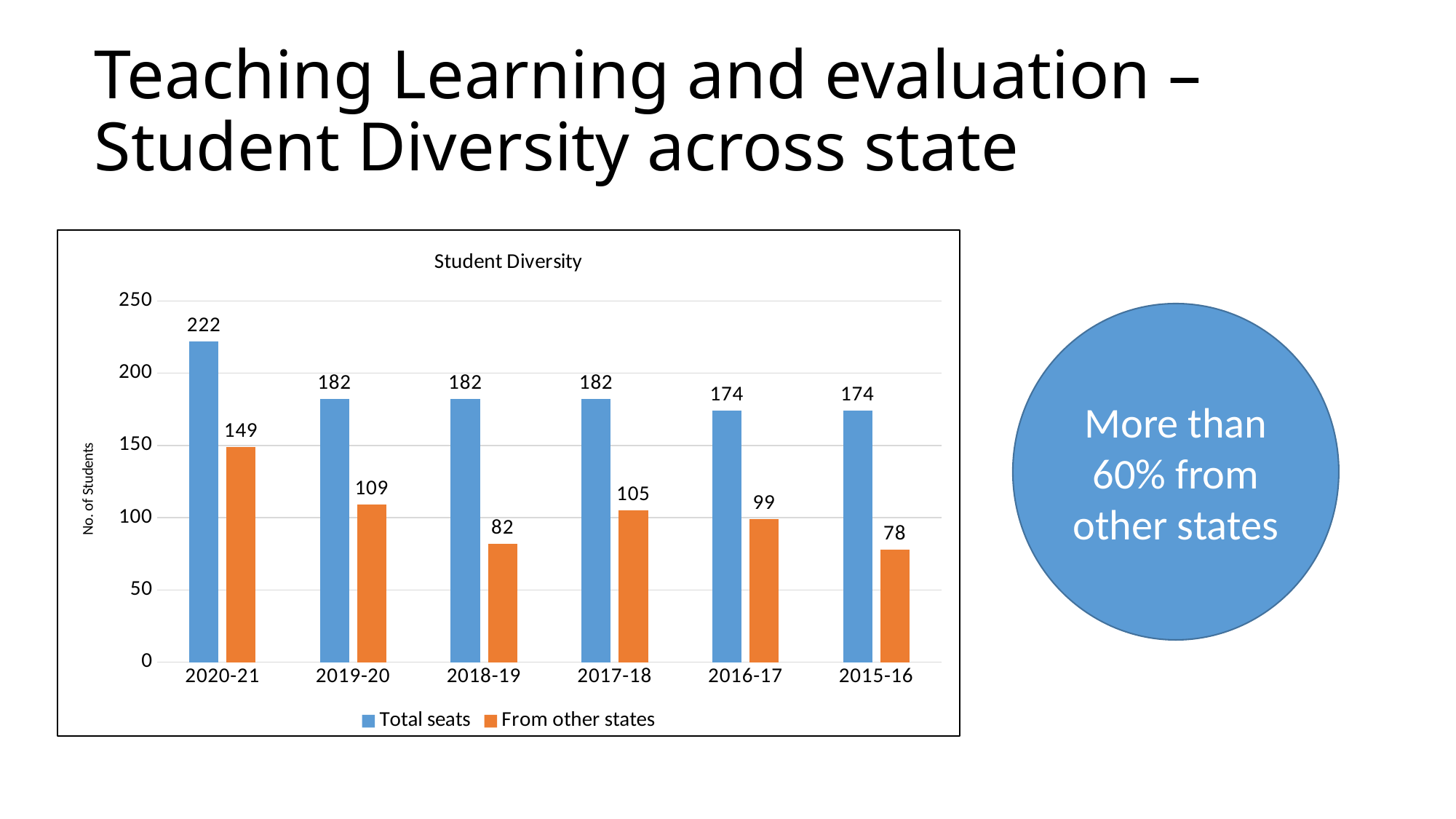
What is the value for From other states in 2018-19? 82 How many series does the legend list? 2 Which year has the highest value for From other states? 2020-21 Which year has the lowest value for From other states? 2015-16 Which is larger: From other states in 2017-18 or From other states in 2016-17? 2017-18 What is the value for From other states in 2016-17? 99 What kind of chart is shown? bar chart What is the difference between Total seats and From other states in 2019-20? 73 What is the title of the chart? Student Diversity How many years are shown on the x axis? 6 What is the value for Total seats in 2020-21? 222 Is the value for From other states in 2015-16 greater or less than 100? less